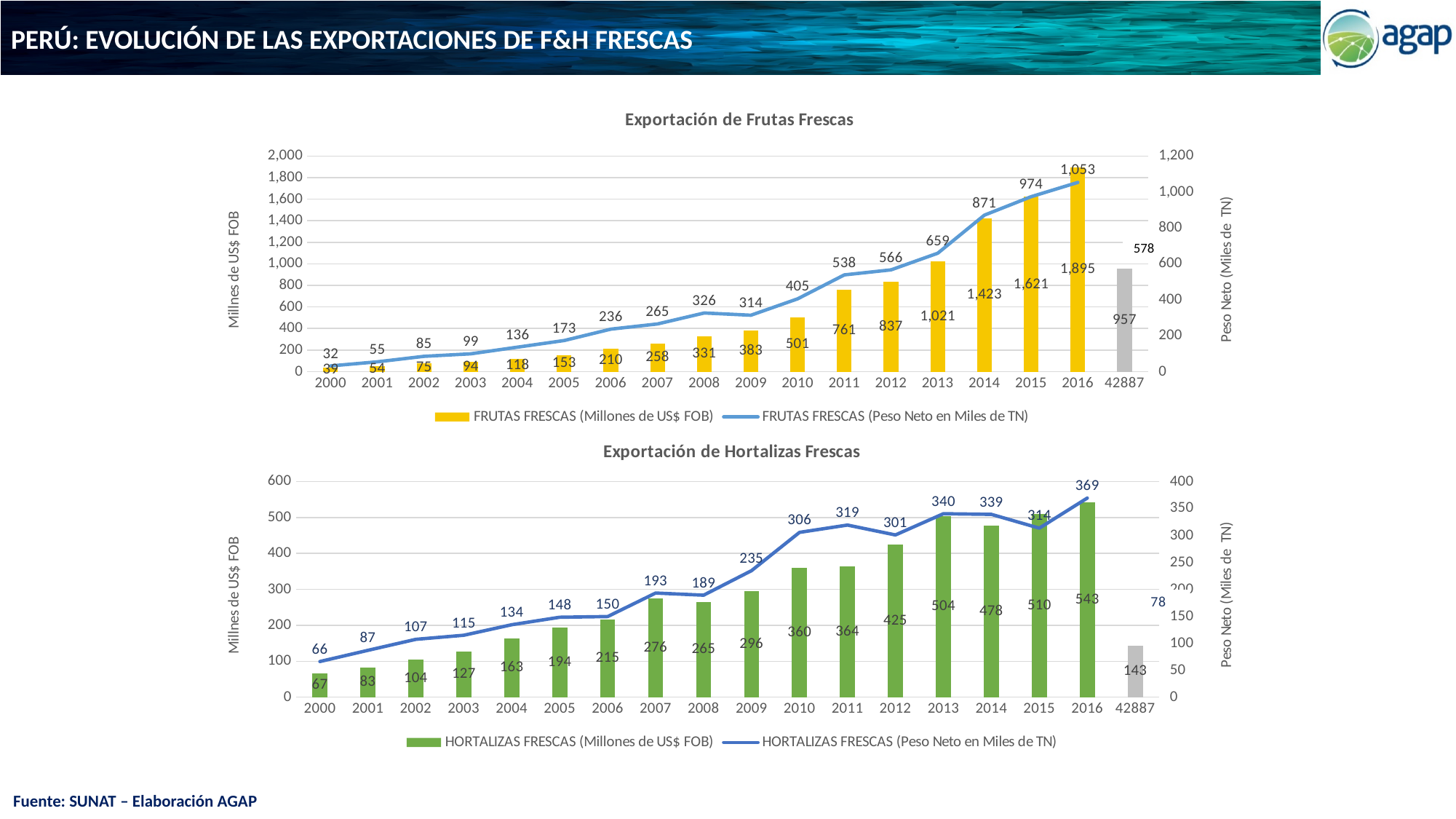
In the 'Exportación de Frutas Frescas' chart, does the FRUTAS FRESCAS (Millones de US$ FOB) series generally rise or fall from 2000 to 2016? Rise In the 'Exportación de Frutas Frescas' chart, which year has the highest value for FRUTAS FRESCAS (Millones de US$ FOB)? 2016 In the 'Exportación de Hortalizas Frescas' chart, what colour are the HORTALIZAS FRESCAS (Millones de US$ FOB) bars? Green In the 'Exportación de Frutas Frescas' chart, what is the value of FRUTAS FRESCAS (Peso Neto en Miles de TN) for 2014? 871 In the 'Exportación de Hortalizas Frescas' chart, which is larger for HORTALIZAS FRESCAS (Millones de US$ FOB): 2007 or 2008? 2007 In the 'Exportación de Hortalizas Frescas' chart, which year has the lowest value for HORTALIZAS FRESCAS (Millones de US$ FOB)? 2000 In the 'Exportación de Frutas Frescas' chart, how many series does the legend list? 2 In the 'Exportación de Frutas Frescas' chart, what is the difference between the FRUTAS FRESCAS (Millones de US$ FOB) values for 2015 and 2014? 198 In the 'Exportación de Hortalizas Frescas' chart, what is the value of HORTALIZAS FRESCAS (Peso Neto en Miles de TN) for 2010? 306 In the 'Exportación de Hortalizas Frescas' chart, what is the difference between the HORTALIZAS FRESCAS (Peso Neto en Miles de TN) values for 2016 and 2015? 55 In the 'Exportación de Hortalizas Frescas' chart, what is the value of HORTALIZAS FRESCAS (Millones de US$ FOB) for 2013? 504 In the 'Exportación de Frutas Frescas' chart, what is the value of FRUTAS FRESCAS (Millones de US$ FOB) for 2016? 1,895